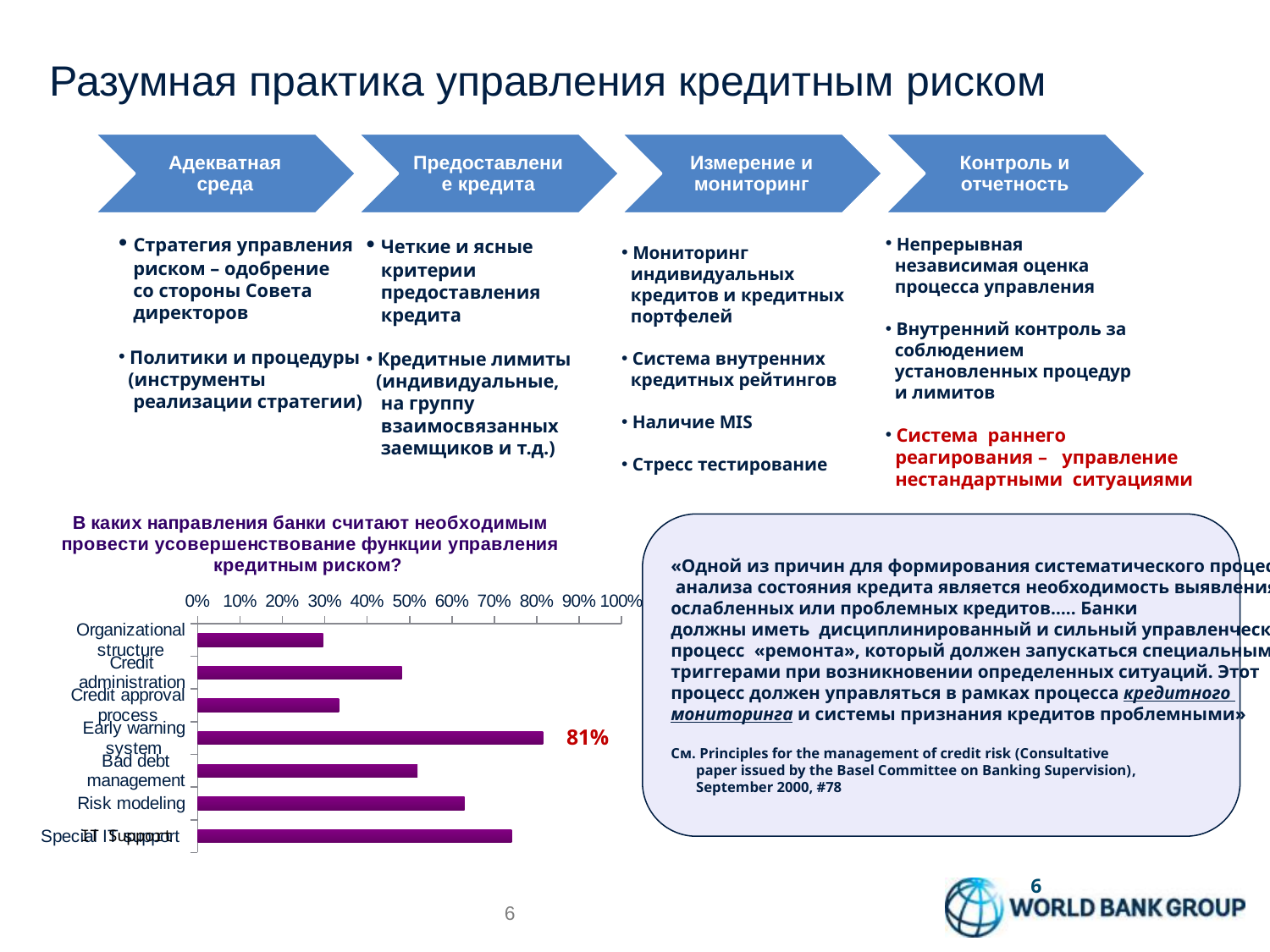
Is the value for Credit approval process greater or less than 40%? less Is the value for the bottom bar (IT support) greater or less than 60%? greater Which is larger, the value for Early warning system or the value for Bad debt management? Early warning system How many categories are shown in the bar chart? 7 Is the value for Risk modeling greater or less than 50%? greater What value is labelled on the bar for Early warning system? 81% What kind of chart is shown on the slide? Bar chart What is the maximum value shown on the chart's percentage axis? 100% Which is larger, the value for Risk modeling or the value for Credit administration? Risk modeling Which category has the highest value in the bar chart? Early warning system Which category has the lowest value in the bar chart? Organizational structure